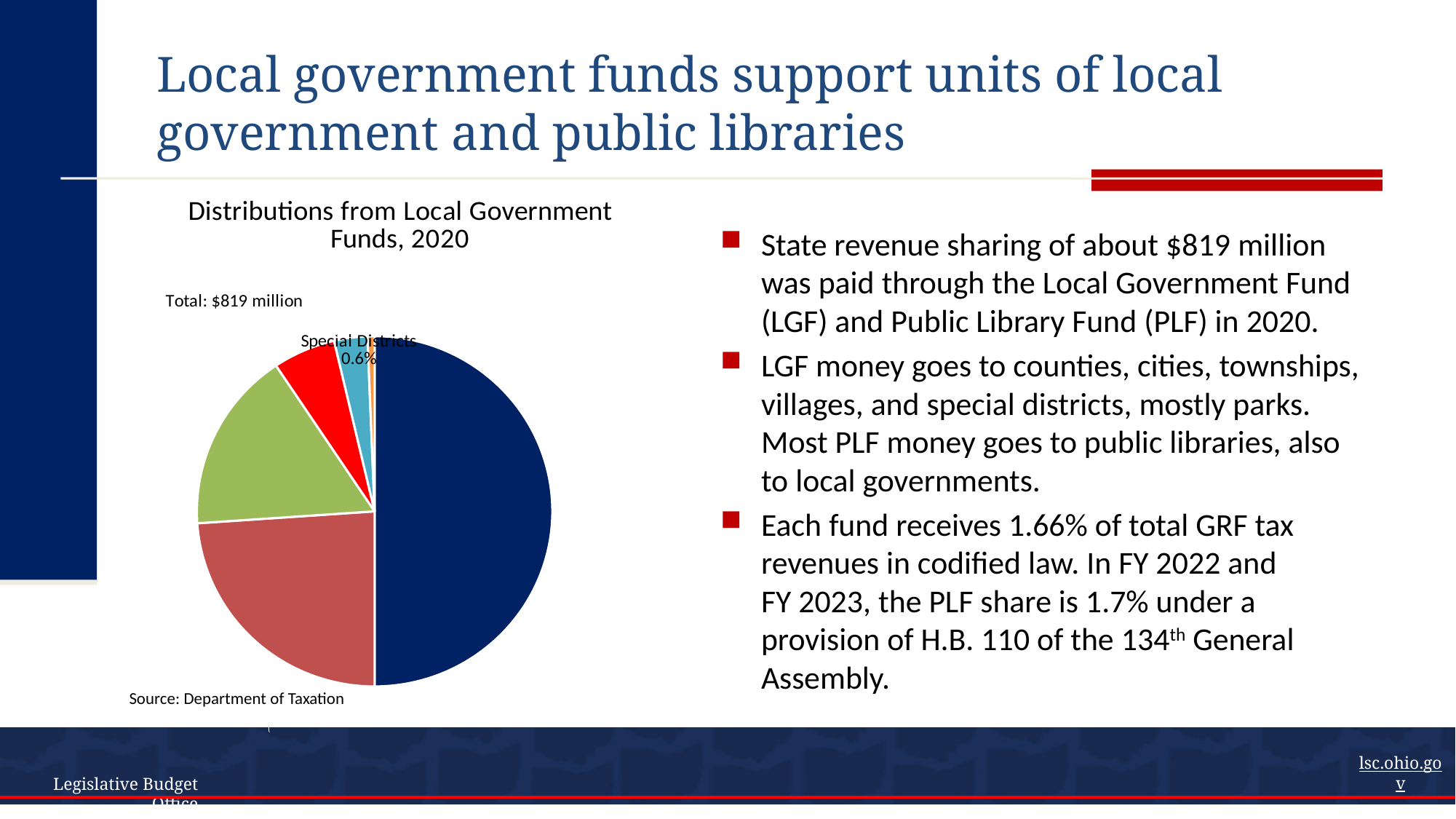
Is the share for Special Districts greater or less than 1%? less Which colour slice is the largest in the pie chart? The dark blue slice What share of the pie is labelled for Special Districts? 0.6% What is the title of the chart on the slide? Distributions from Local Government Funds, 2020 What source is cited for the chart? Department of Taxation Is the dark blue slice larger or smaller than the green slice? Larger What total amount is stated for the distributions in the chart? $819 million What type of chart is shown on the slide? Pie chart